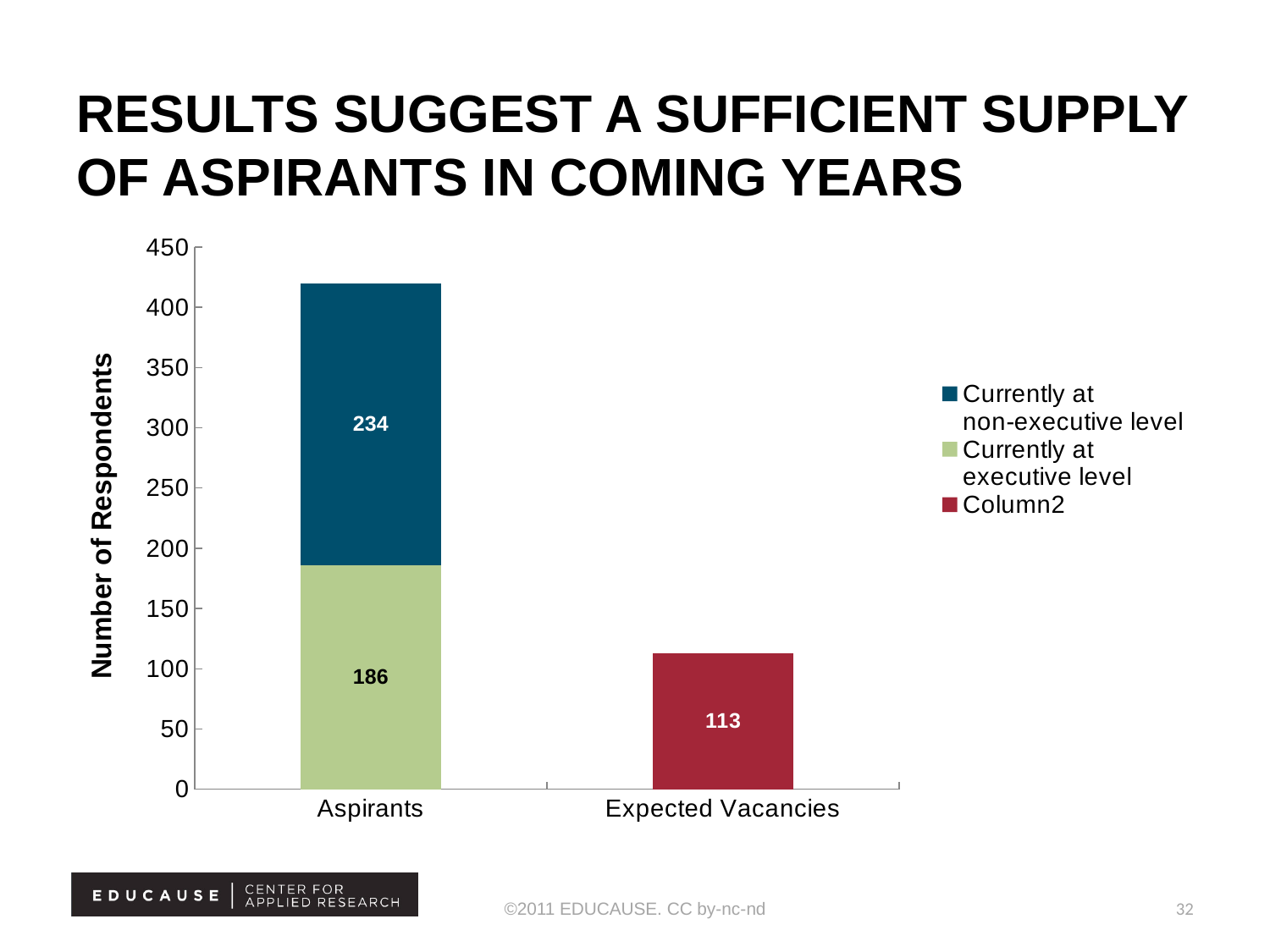
Is the total height of the Aspirants bar greater or less than 400? greater How many categories are shown on the x axis? 2 What is the difference between the non-executive level aspirants (234) and the executive level aspirants (186)? 48 What is the value for 'Currently at non-executive level' in the Aspirants bar? 234 What is the value shown for Expected Vacancies? 113 What kind of chart is shown on the slide? Stacked bar chart What is the value for 'Currently at executive level' in the Aspirants bar? 186 Which is larger: the number of aspirants currently at executive level or the number of expected vacancies? Aspirants currently at executive level What is the label of the y axis? Number of Respondents Is the value for Expected Vacancies greater or less than 150? less How many series does the legend list? 3 What is the total of the stacked Aspirants bar? 420